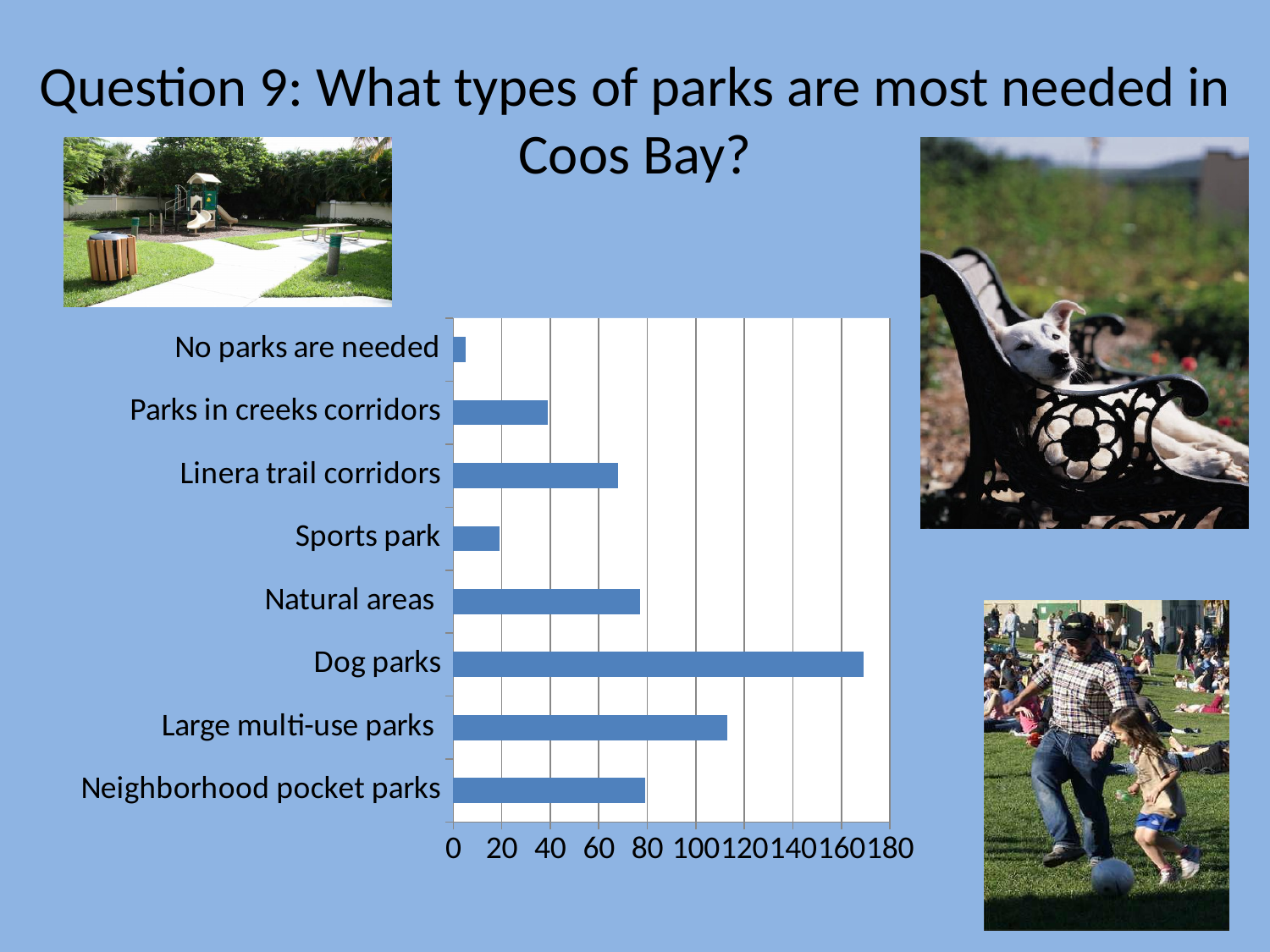
Which category has the lowest value in the chart? No parks are needed Is the value for No parks are needed greater or less than 20? less Is the value for Linera trail corridors greater or less than 60? greater Which is larger, the value for Dog parks or the value for Large multi-use parks? Dog parks Is the value for Sports park greater or less than 40? less How many park types (categories) are shown in the chart? 8 Which is larger, the value for Linera trail corridors or the value for Sports park? Linera trail corridors What kind of chart is shown on the slide? bar chart Which category has the highest value in the chart? Dog parks What is the highest value shown on the chart's horizontal axis? 180